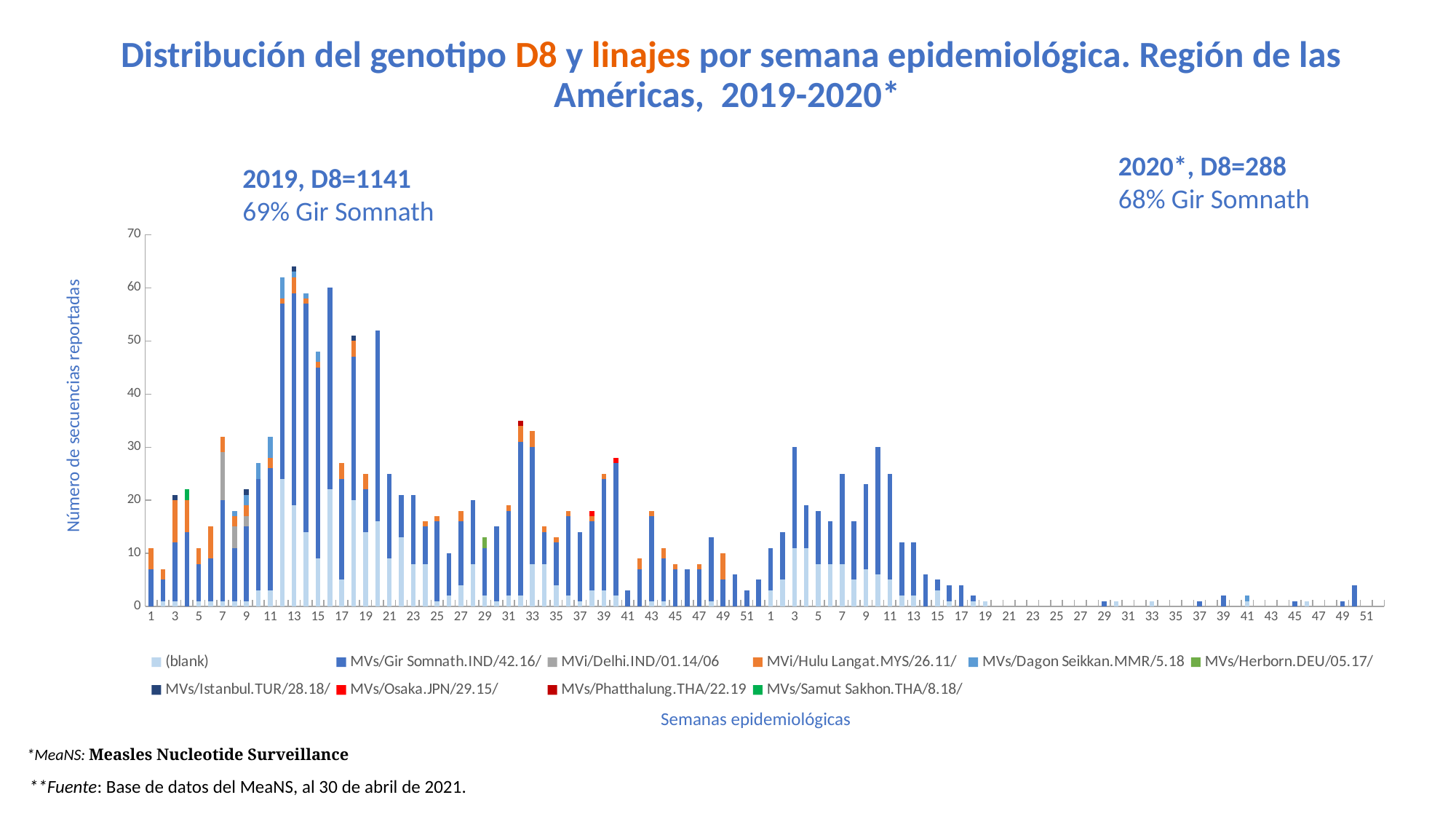
Is the total value for epidemiological week 15 of 2019 greater or less than 50? less What kind of chart is shown on the slide? bar chart Is the total value for epidemiological week 20 of 2019 greater or less than 50? greater What percentage of 2019 D8 sequences were Gir Somnath, according to the chart annotation? 69% What percentage of 2020* D8 sequences were Gir Somnath, according to the chart annotation? 68% How many series does the legend list? 10 What is the title of the vertical axis? Número de secuencias reportadas Which has the larger total: epidemiological week 20 of 2019 or week 21 of 2019? week 20 of 2019 According to the annotation on the chart, what was the D8 total for 2020*? 288 Is the total value for epidemiological week 13 of 2019 greater or less than 60? greater According to the annotation on the chart, what was the D8 total for 2019? 1141